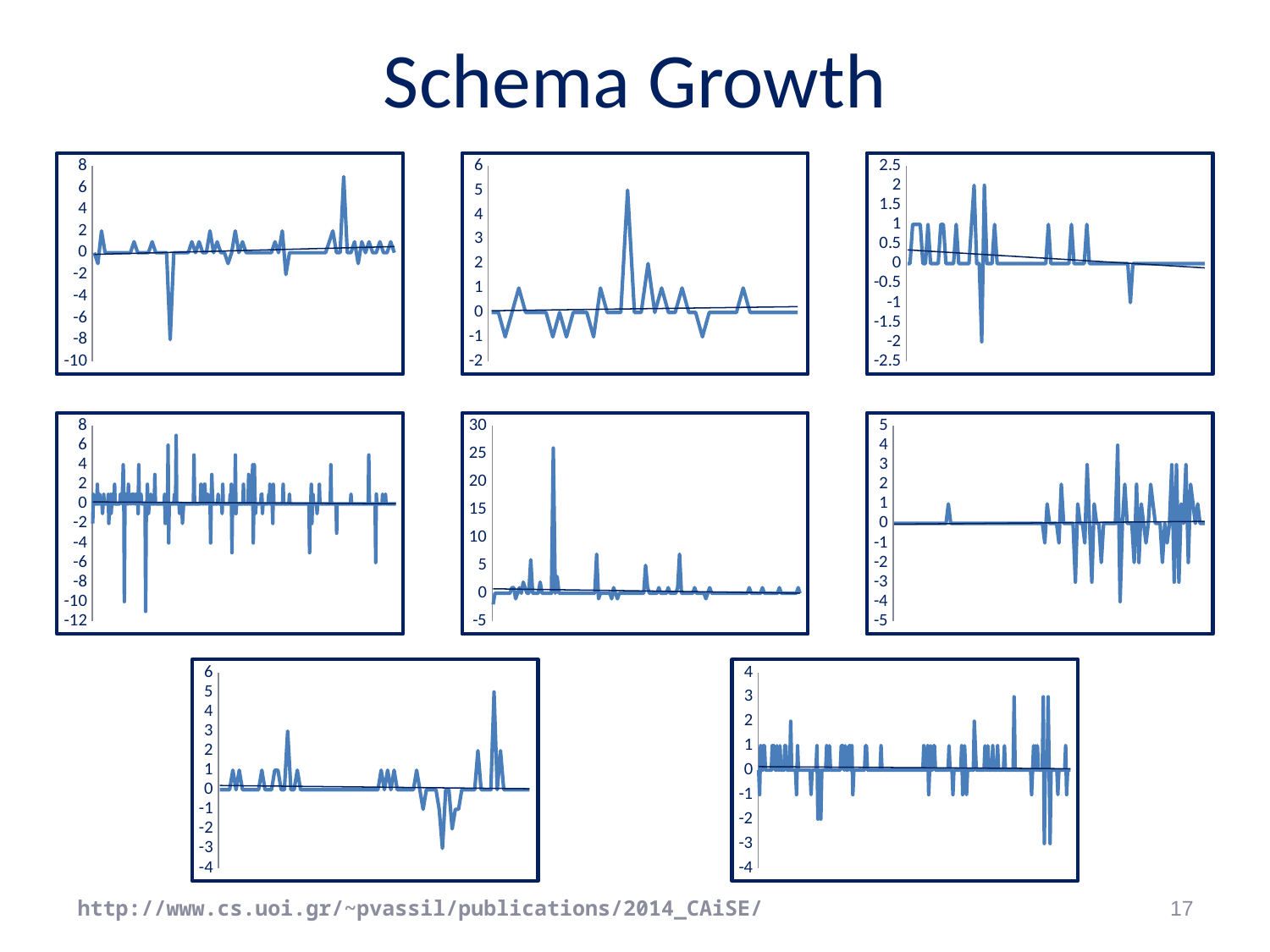
In the top-left chart, is the highest peak greater or less than 4? greater How many charts are shown on the slide? 8 In the top-left chart, is the lowest value on the line greater or less than -6? less What kind of chart is the top-left chart? line chart In the bottom-right chart, is the highest peak greater or less than 2? greater What is the title of the slide containing the charts? Schema Growth What is the maximum value shown on the y-axis of the middle chart in the second row? 30 In the top-right chart, does the thin trend line rise or fall from left to right? fall